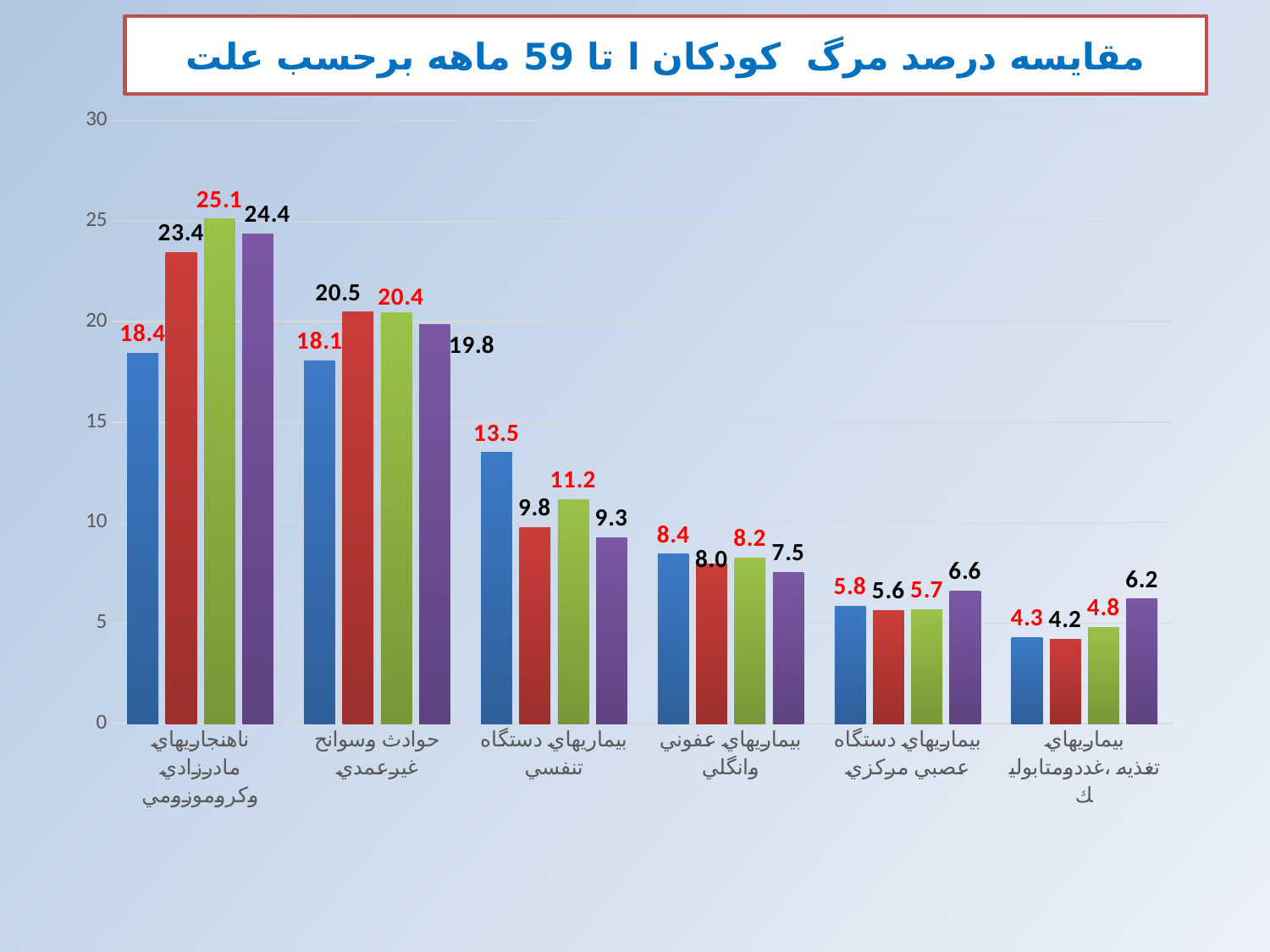
What is the difference between the green bar (25.1) and the blue bar (18.4) for ناهنجاريهاي مادرزادي وكروموزومي? 6.7 What is the value of the blue bar for بيماريهاي دستگاه تنفسي? 13.5 Is the value of the purple bar for حوادث وسوانح غيرعمدي greater or less than 20? less Which category has the lowest value among all bars on the chart? بيماريهاي تغذيه، غددومتابوليك How many categories (causes of death) are shown on the x axis? 6 What is the value of the green bar for ناهنجاريهاي مادرزادي وكروموزومي? 25.1 Which is larger for بيماريهاي دستگاه تنفسي: the blue bar or the red bar? the blue bar Which category has the highest value among all bars on the chart? ناهنجاريهاي مادرزادي وكروموزومي What is the value of the purple bar for بيماريهاي تغذيه، غددومتابوليك? 6.2 What kind of chart is shown on the slide? bar chart What is the title of the chart on the slide? مقایسه درصد مرگ کودکان ۱ تا 59 ماهه برحسب علت What is the value of the red bar for حوادث وسوانح غيرعمدي? 20.5